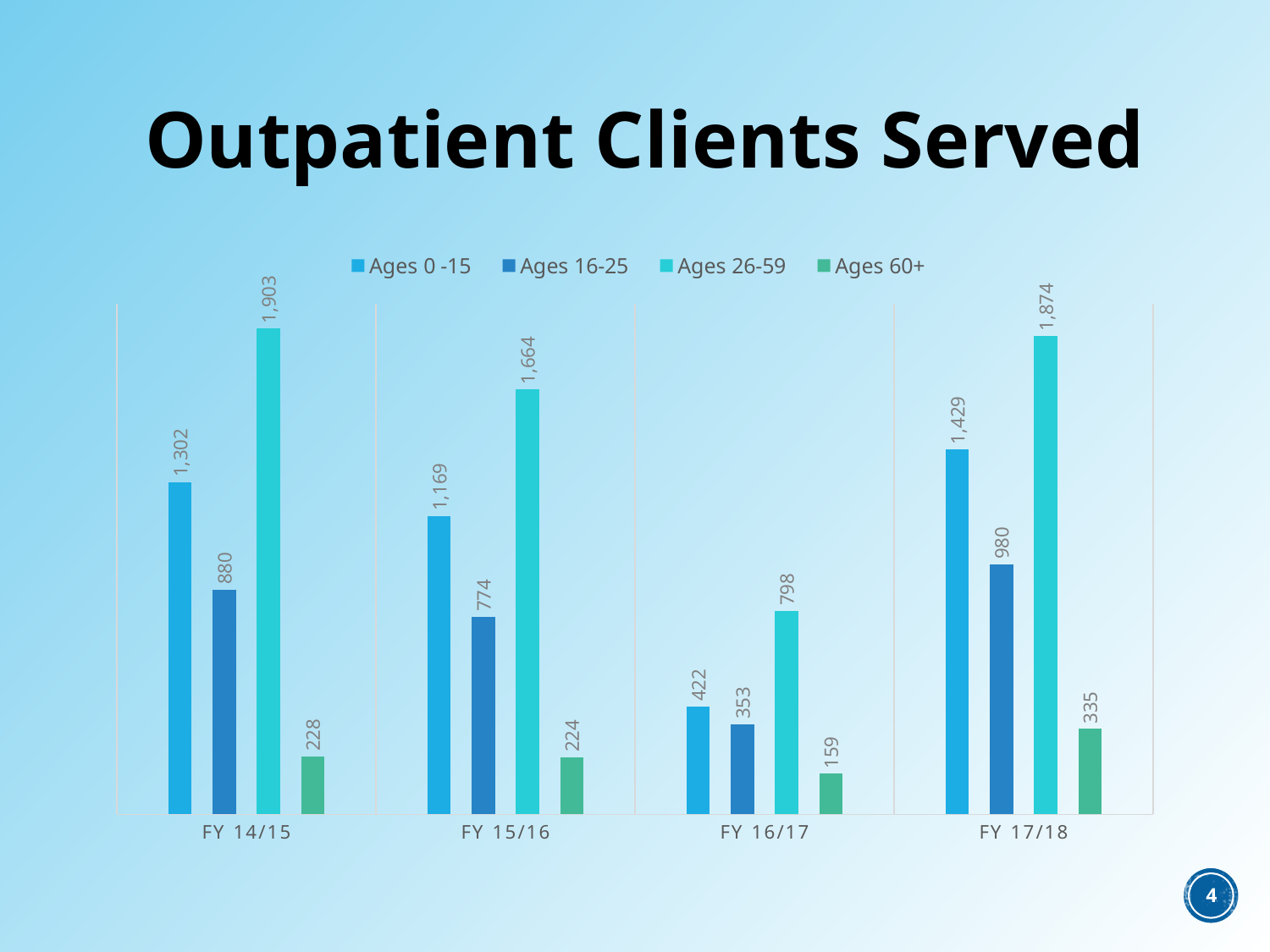
How many fiscal years are shown on the x axis? 4 What is the title of the slide? Outpatient Clients Served Which is larger: Ages 60+ in FY 14/15 or Ages 60+ in FY 15/16? Ages 60+ in FY 14/15 What is the value for Ages 26-59 in FY 14/15? 1,903 What kind of chart is shown on the slide? Bar chart What is the value for Ages 0-15 in FY 17/18? 1,429 What is the difference between the Ages 16-25 values in FY 17/18 and FY 16/17? 627 Which fiscal year has the lowest value for Ages 0-15? FY 16/17 Which fiscal year has the highest value for Ages 26-59? FY 14/15 What is the value for Ages 60+ in FY 16/17? 159 What is the value for Ages 16-25 in FY 15/16? 774 How many series does the legend list? 4